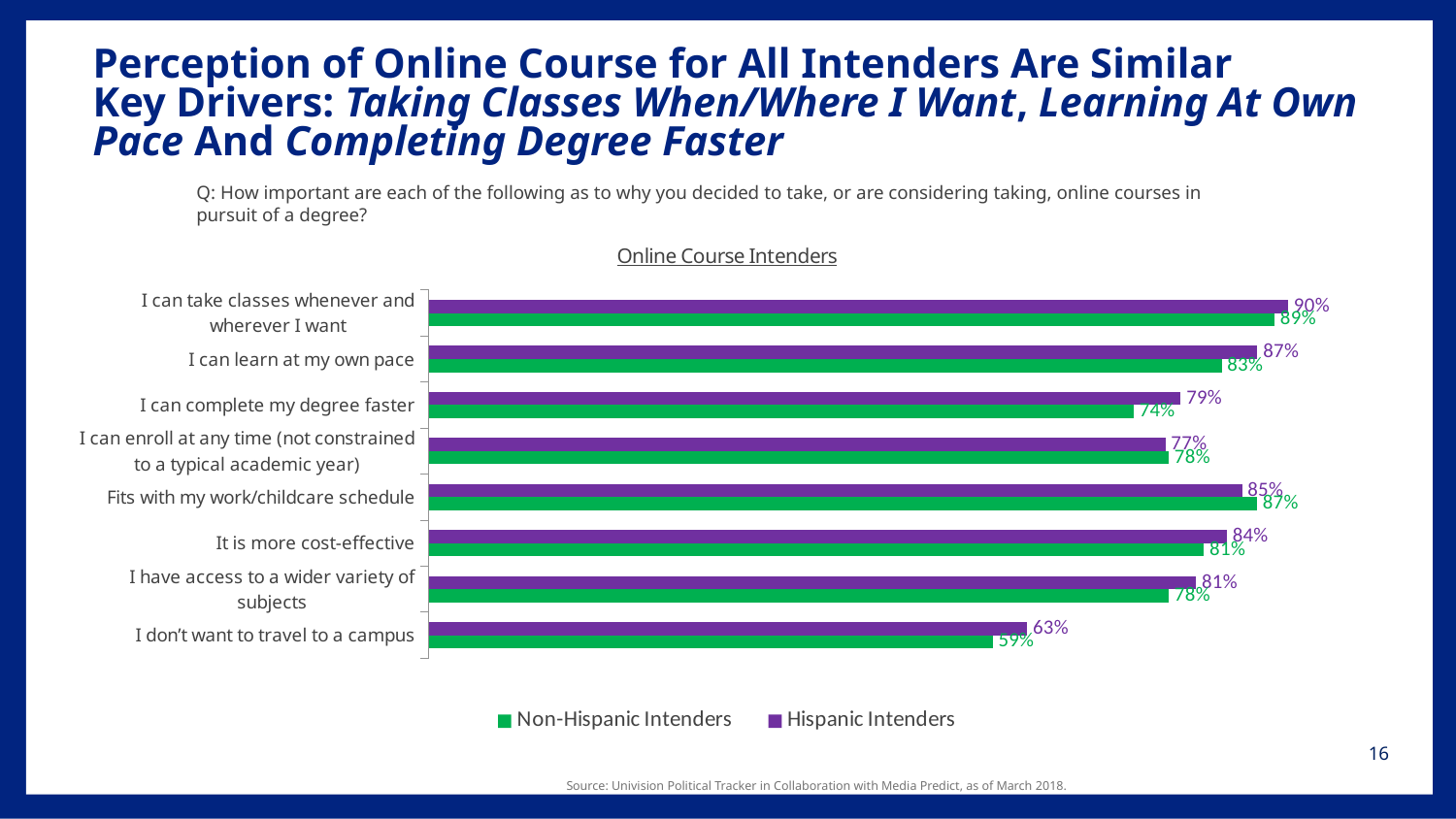
What is the value for Hispanic Intenders for "I can complete my degree faster"? 79% What is the value for Non-Hispanic Intenders for "I don't want to travel to a campus"? 59% How many series does the legend list? 2 Which category has the lowest value for Hispanic Intenders? I don't want to travel to a campus Which colour represents Hispanic Intenders in the chart? Purple For "Fits with my work/childcare schedule", which series has the larger value, Non-Hispanic Intenders or Hispanic Intenders? Non-Hispanic Intenders What kind of chart is shown on the slide? Bar chart How many categories are shown in the chart? 8 What is the value for Hispanic Intenders for "I can take classes whenever and wherever I want"? 90% What is the difference between Hispanic Intenders and Non-Hispanic Intenders for "I can complete my degree faster"? 5% Which category has the highest value for Hispanic Intenders? I can take classes whenever and wherever I want What is the value for Non-Hispanic Intenders for "I can learn at my own pace"? 83%